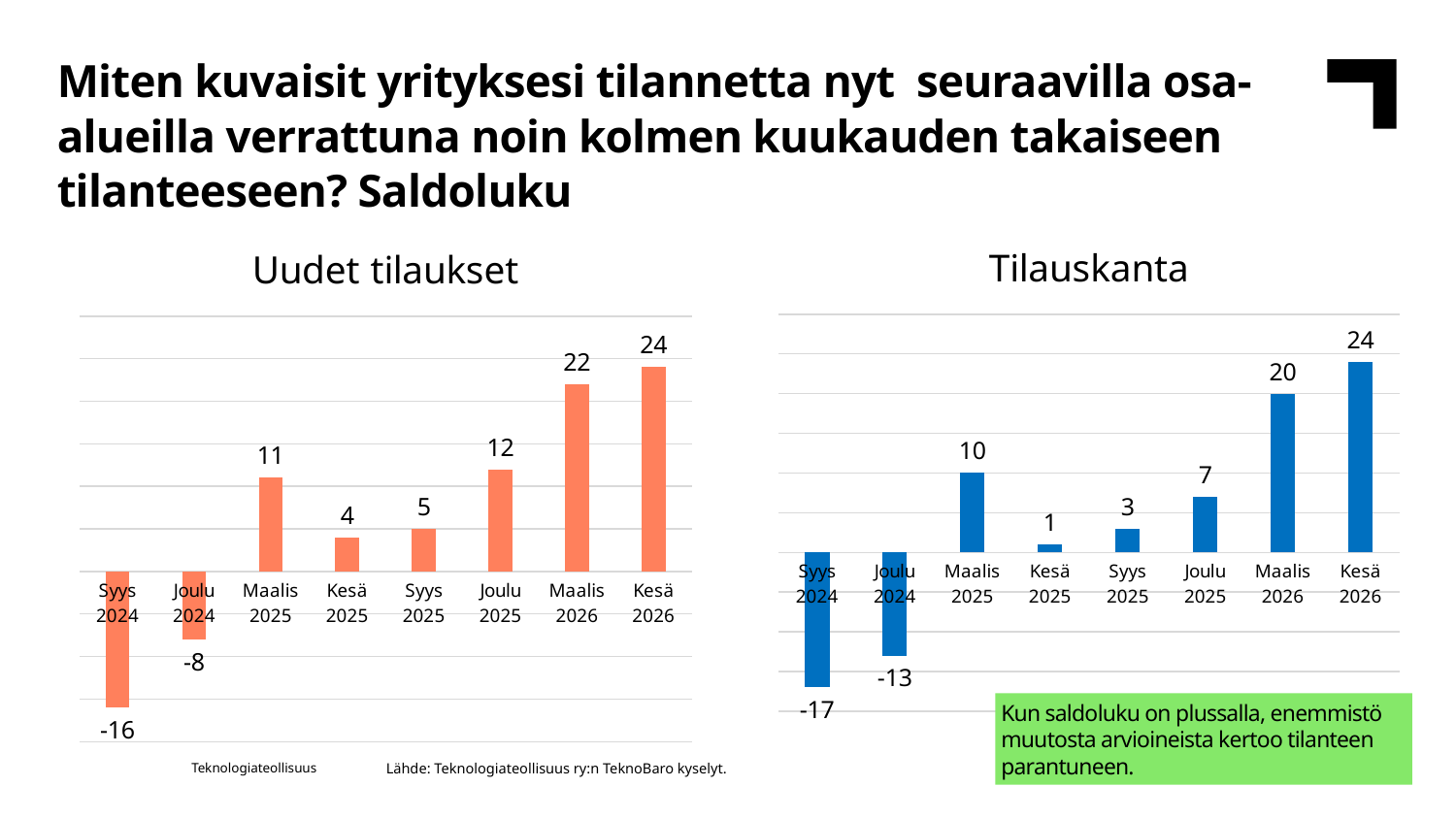
How many categories are shown in the 'Tilauskanta' chart? 8 In the 'Tilauskanta' chart, what is the difference between the values for Maalis 2025 and Kesä 2025? 9 In the 'Tilauskanta' chart, which is larger: the value for Maalis 2025 or the value for Syys 2025? Maalis 2025 In the 'Tilauskanta' chart, which category has the lowest value? Syys 2024 In the 'Uudet tilaukset' chart, which category has the highest value? Kesä 2026 In the 'Uudet tilaukset' chart, what is the value for Syys 2024? -16 What kind of chart is the 'Uudet tilaukset' chart? Bar chart In the 'Uudet tilaukset' chart, which is larger: the value for Kesä 2025 or the value for Joulu 2025? Joulu 2025 In the 'Tilauskanta' chart, do the values generally rise or fall from Joulu 2025 to Kesä 2026? Rise In the 'Uudet tilaukset' chart, what is the difference between the values for Maalis 2026 and Joulu 2025? 10 In the 'Tilauskanta' chart, what is the value for Joulu 2025? 7 What is the title of the chart on the right side of the slide? Tilauskanta